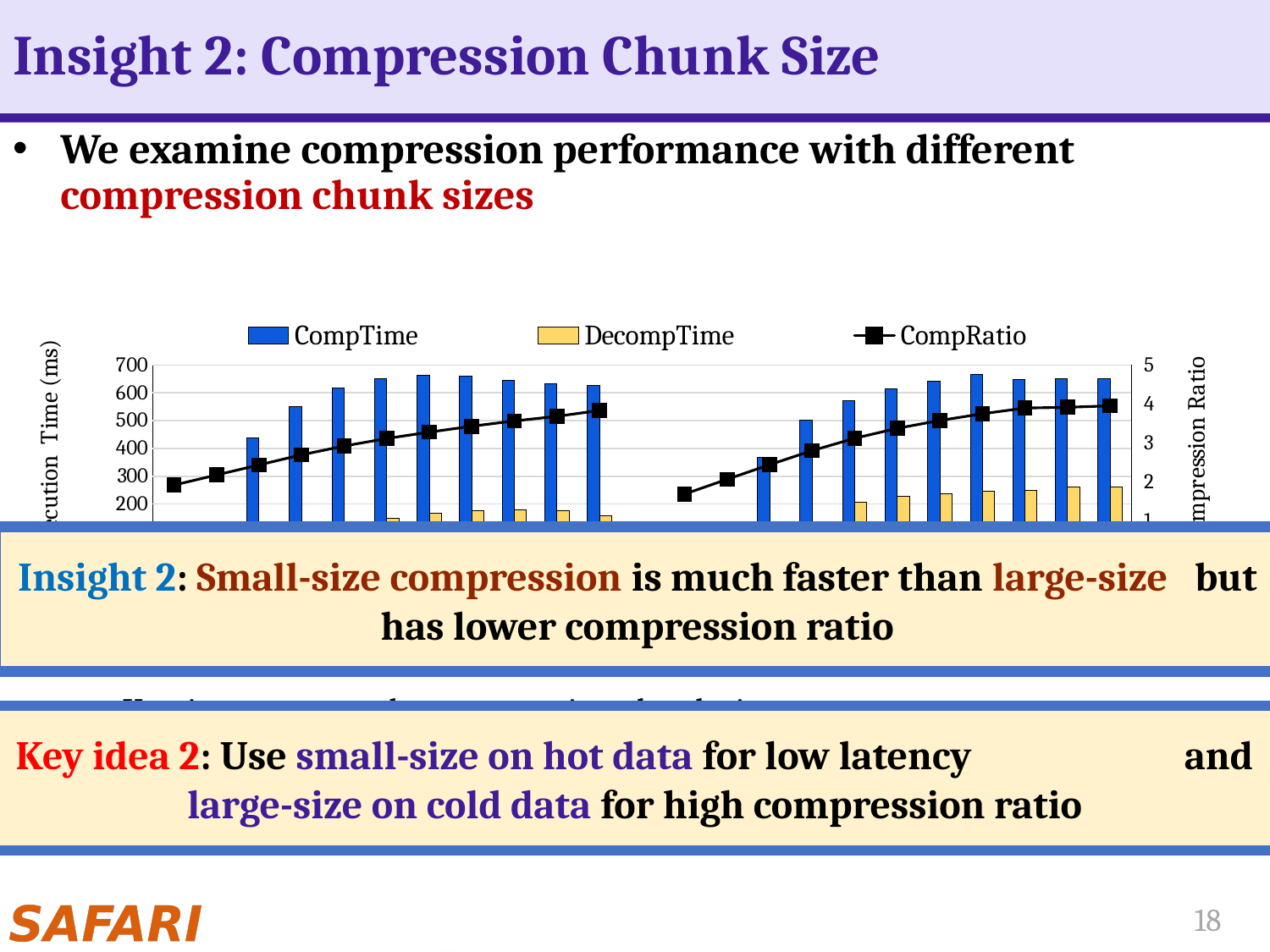
What are the three series named in the chart legend? CompTime, DecompTime, CompRatio Is the tallest CompTime bar in the chart greater or less than 600? greater What is the maximum value shown on the right y-axis (Compression Ratio) of the chart? 5 Is the rightmost CompRatio point in the chart greater or less than 3? greater What is the maximum value shown on the left y-axis of the chart? 700 Does the CompRatio line rise or fall from left to right within each group of the chart? Rise Which series has taller bars in the chart, CompTime or DecompTime? CompTime How many series does the chart legend list? 3 What kind of chart is shown on the slide? Combined bar and line chart